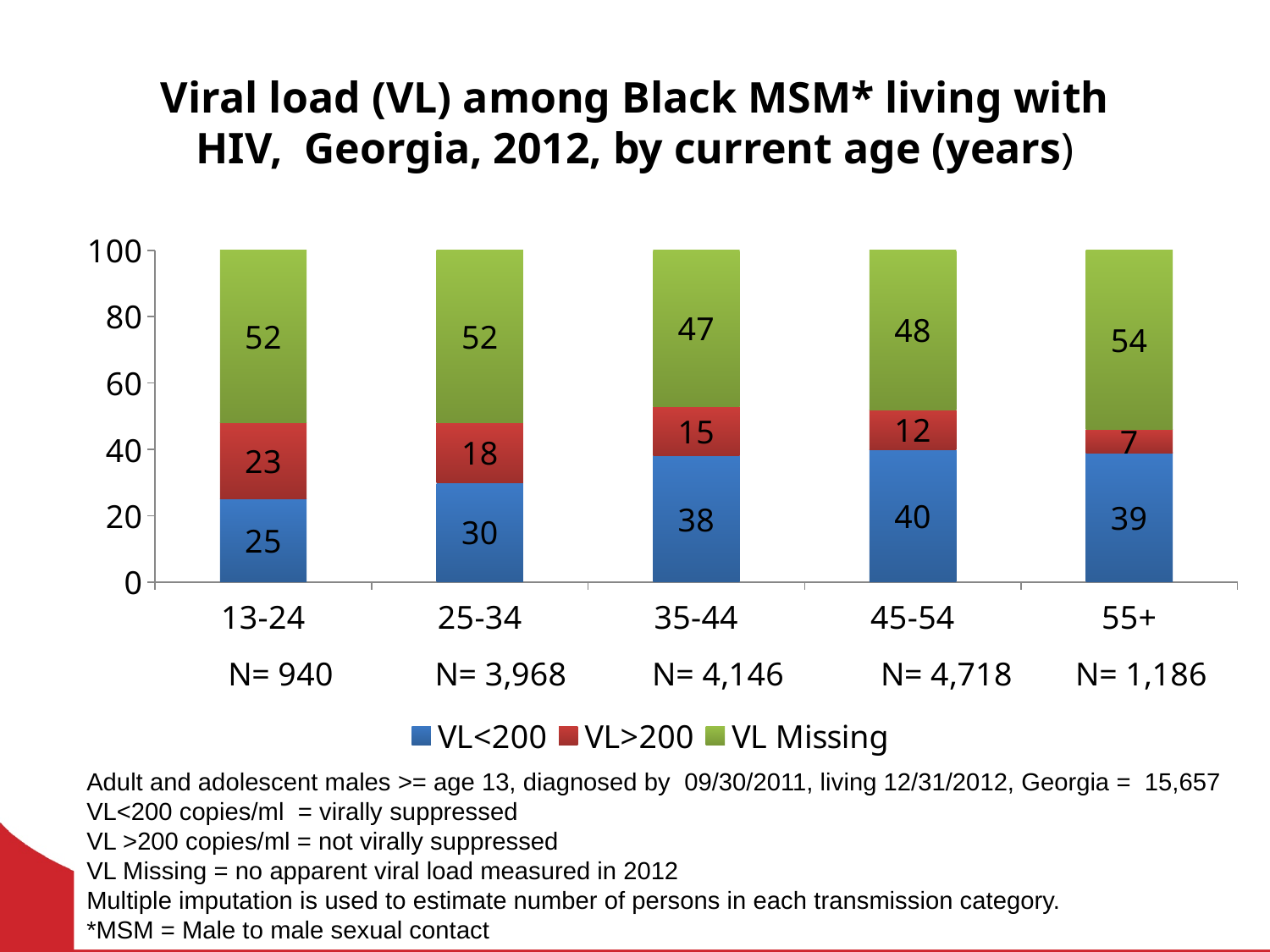
What is the N value shown for the 45-54 age group? N= 4,718 What is the difference between the VL>200 values for the 13-24 and 55+ age groups? 16 What kind of chart is shown on the slide? Stacked bar chart Which is larger, the VL Missing value for 35-44 or for 45-54? 45-54 How many series does the legend list? 3 What is the total of the stacked bar for the 25-34 age group? 100 How many age groups are shown on the x axis? 5 What is the VL>200 value for the 35-44 age group? 15 What is the VL<200 value for the 13-24 age group? 25 Which age group has the highest VL<200 value? 45-54 What is the VL Missing value for the 55+ age group? 54 Which age group has the lowest VL>200 value? 55+